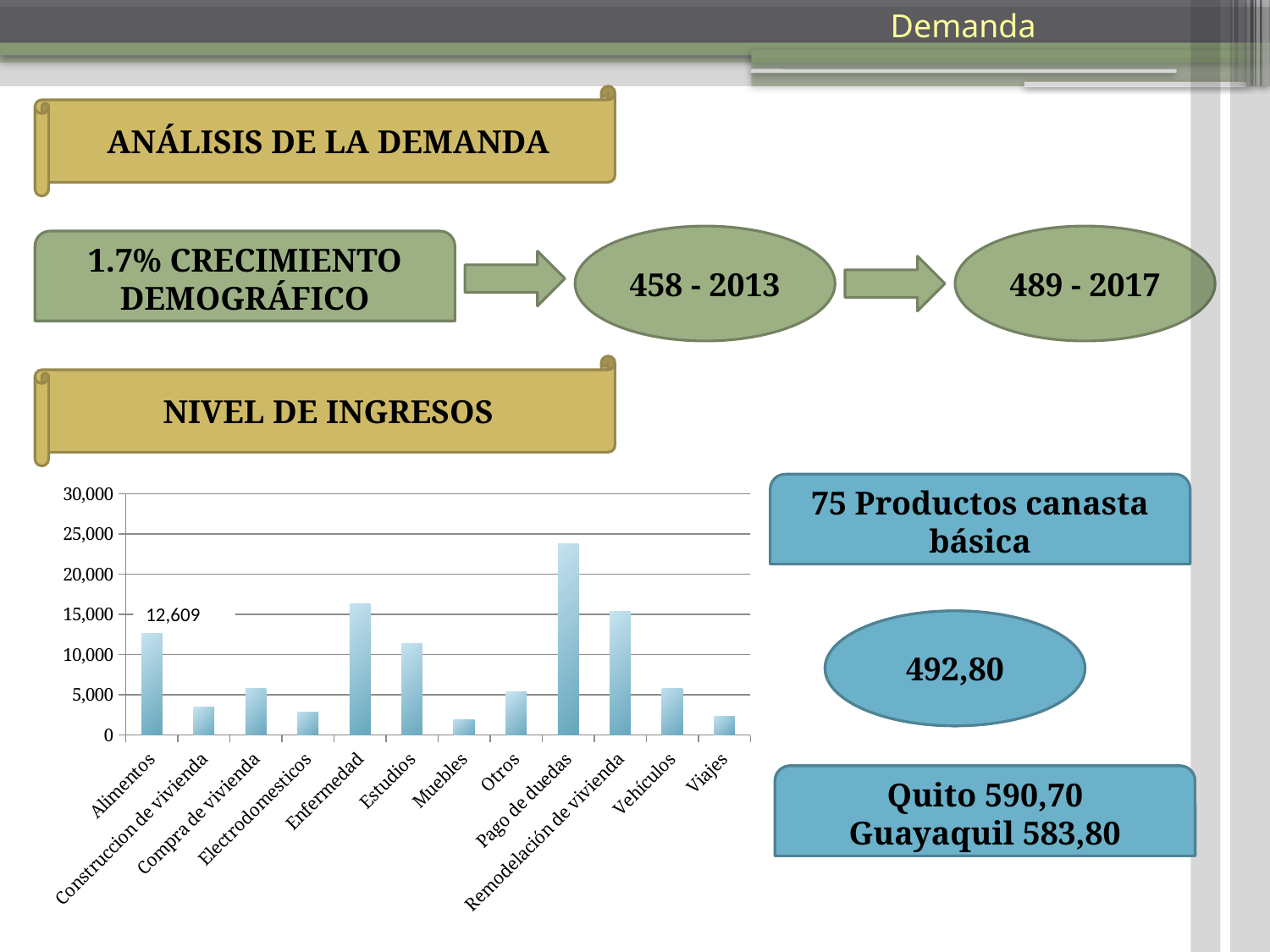
Is the value for Muebles greater or less than 5,000? less Is the value for Pago de duedas greater or less than 20,000? greater Is the value for Enfermedad greater or less than 15,000? greater Which category has the highest bar in the chart? Pago de duedas Which is larger, the value for Enfermedad or the value for Estudios? Enfermedad How many categories are plotted in the bar chart? 12 What is the highest value shown on the vertical axis of the bar chart? 30,000 Which is larger, the value for Remodelación de vivienda or the value for Alimentos? Remodelación de vivienda What value is shown for Alimentos in the bar chart? 12,609 What kind of chart is shown on the slide? bar chart